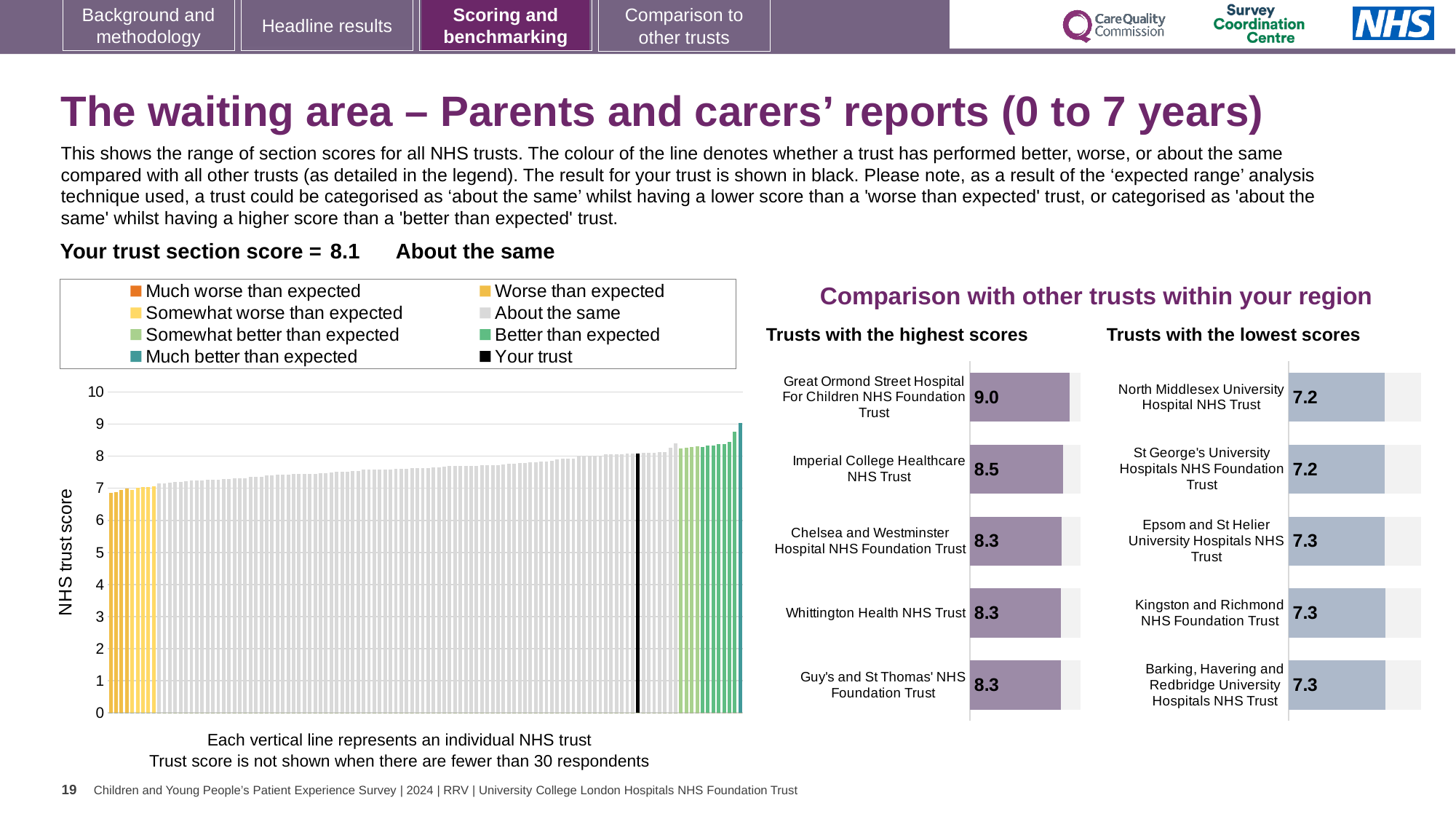
In the large chart on the left, is the value of the tallest bar greater or less than 8? greater What is the y-axis label of the large chart on the left? NHS trust score In the 'Trusts with the highest scores' chart, what is the score for Great Ormond Street Hospital For Children NHS Foundation Trust? 9.0 How many trusts are listed in the 'Trusts with the lowest scores' chart? 5 In the 'Trusts with the highest scores' chart, what is the score for Imperial College Healthcare NHS Trust? 8.5 In the 'Trusts with the highest scores' chart, what is the difference between the scores of Great Ormond Street Hospital For Children NHS Foundation Trust and Imperial College Healthcare NHS Trust? 0.5 In the 'Trusts with the highest scores' chart, which has the larger score: Imperial College Healthcare NHS Trust or Whittington Health NHS Trust? Imperial College Healthcare NHS Trust What type of chart is the large chart on the left showing NHS trust scores? Bar chart How many entries does the legend of the large chart on the left list? 8 In the 'Trusts with the highest scores' chart, which trust has the highest score? Great Ormond Street Hospital For Children NHS Foundation Trust In the 'Trusts with the lowest scores' chart, what is the score for Barking, Havering and Redbridge University Hospitals NHS Trust? 7.3 In the 'Trusts with the lowest scores' chart, what is the score for North Middlesex University Hospital NHS Trust? 7.2